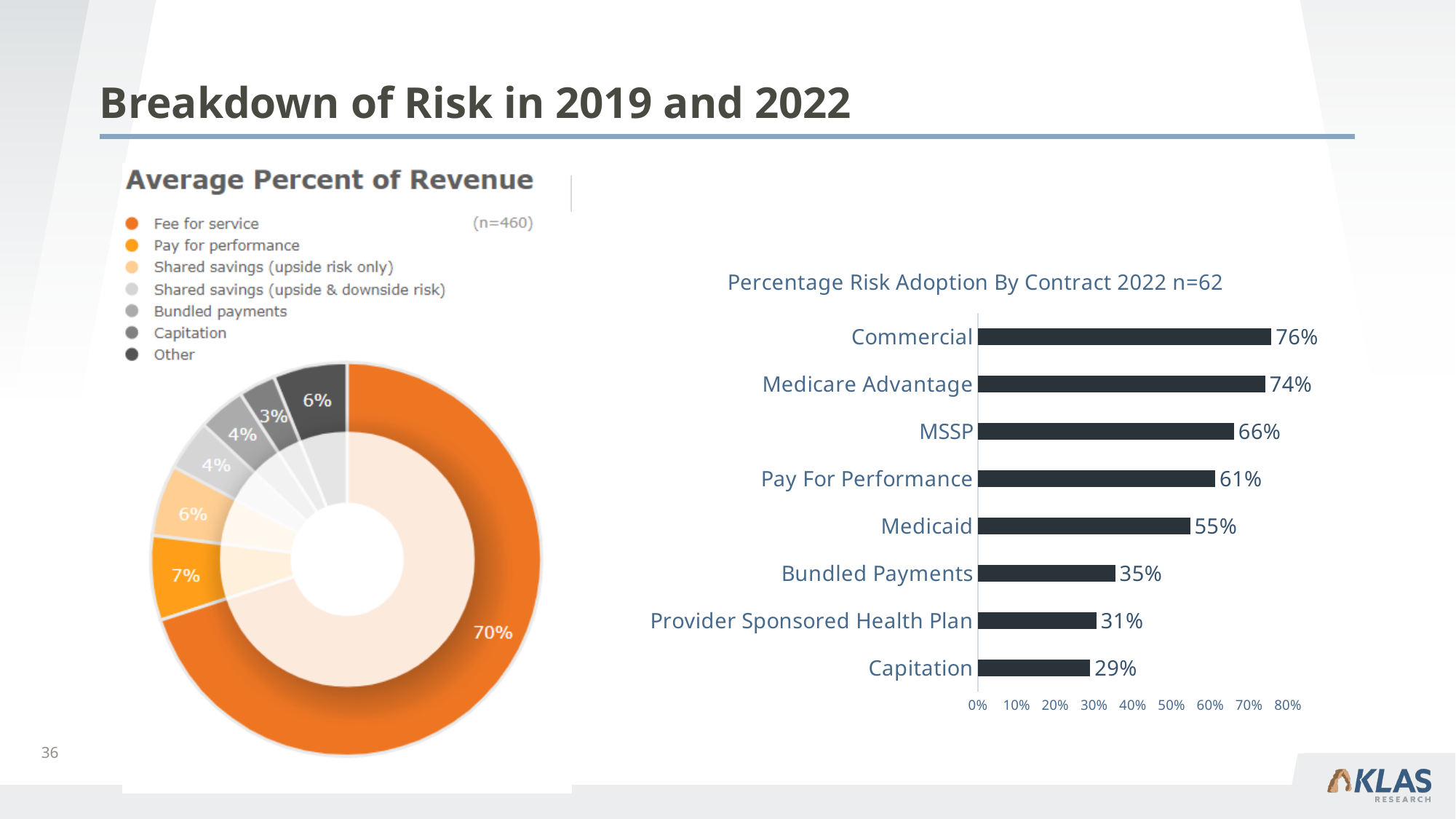
What is the sample size (n) shown for the 'Average Percent of Revenue' chart? n=460 What kind of chart is the 'Percentage Risk Adoption By Contract 2022' chart? Bar chart How many contract types are shown in the 'Percentage Risk Adoption By Contract 2022' bar chart? 8 How many categories does the legend of the 'Average Percent of Revenue' chart list? 7 In the 'Percentage Risk Adoption By Contract 2022' bar chart, which is larger: Pay For Performance or Provider Sponsored Health Plan? Pay For Performance In the 'Percentage Risk Adoption By Contract 2022' bar chart, what is the value for Medicaid? 55% In the 'Percentage Risk Adoption By Contract 2022' bar chart, which contract type has the highest value? Commercial In the 'Percentage Risk Adoption By Contract 2022' bar chart, which contract type has the lowest value? Capitation In the 'Percentage Risk Adoption By Contract 2022' bar chart, what is the value for Commercial? 76% In the 'Percentage Risk Adoption By Contract 2022' bar chart, what is the difference between MSSP and Bundled Payments? 31% In the 'Average Percent of Revenue' donut chart, what share does Pay for performance have? 7% In the 'Average Percent of Revenue' donut chart, what share does Fee for service have? 70%